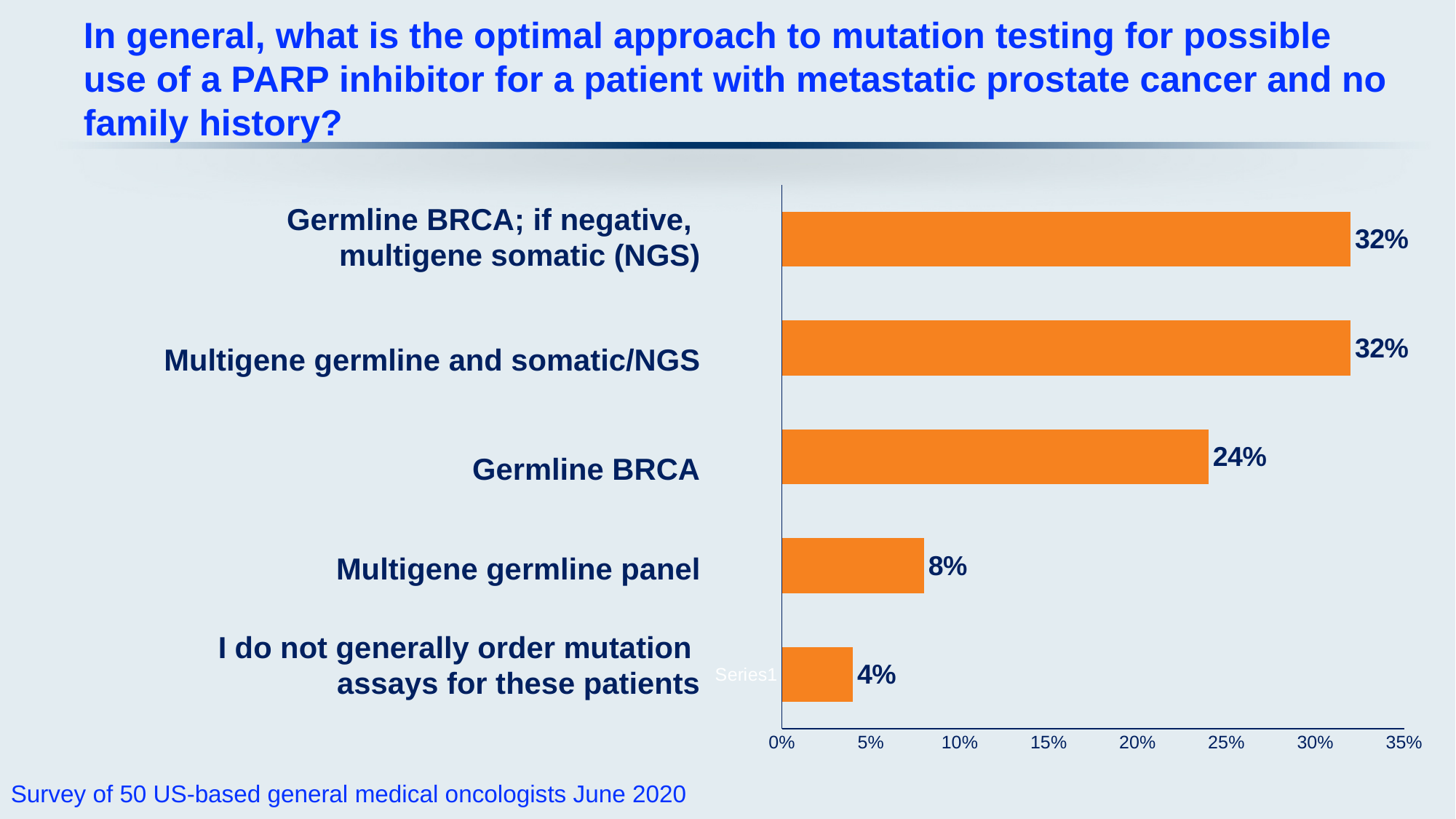
What percentage of respondents said they do not generally order mutation assays for these patients? 4% What percentage of respondents chose "Germline BRCA"? 24% Which category has the lowest value? I do not generally order mutation assays for these patients What is the difference between the value for "Germline BRCA" and the value for "Multigene germline panel"? 16% What is the difference between the value for "Multigene germline and somatic/NGS" and the value for "Germline BRCA"? 8% What is the maximum value shown on the horizontal axis? 35% What is the value for "Multigene germline and somatic/NGS"? 32% What kind of chart is shown on the slide? Bar chart How many categories are shown in the chart? 5 Which is larger: the value for "Germline BRCA" or the value for "Multigene germline panel"? Germline BRCA Is the value for "Germline BRCA" greater or less than 20%? greater What is the value for "Multigene germline panel"? 8%